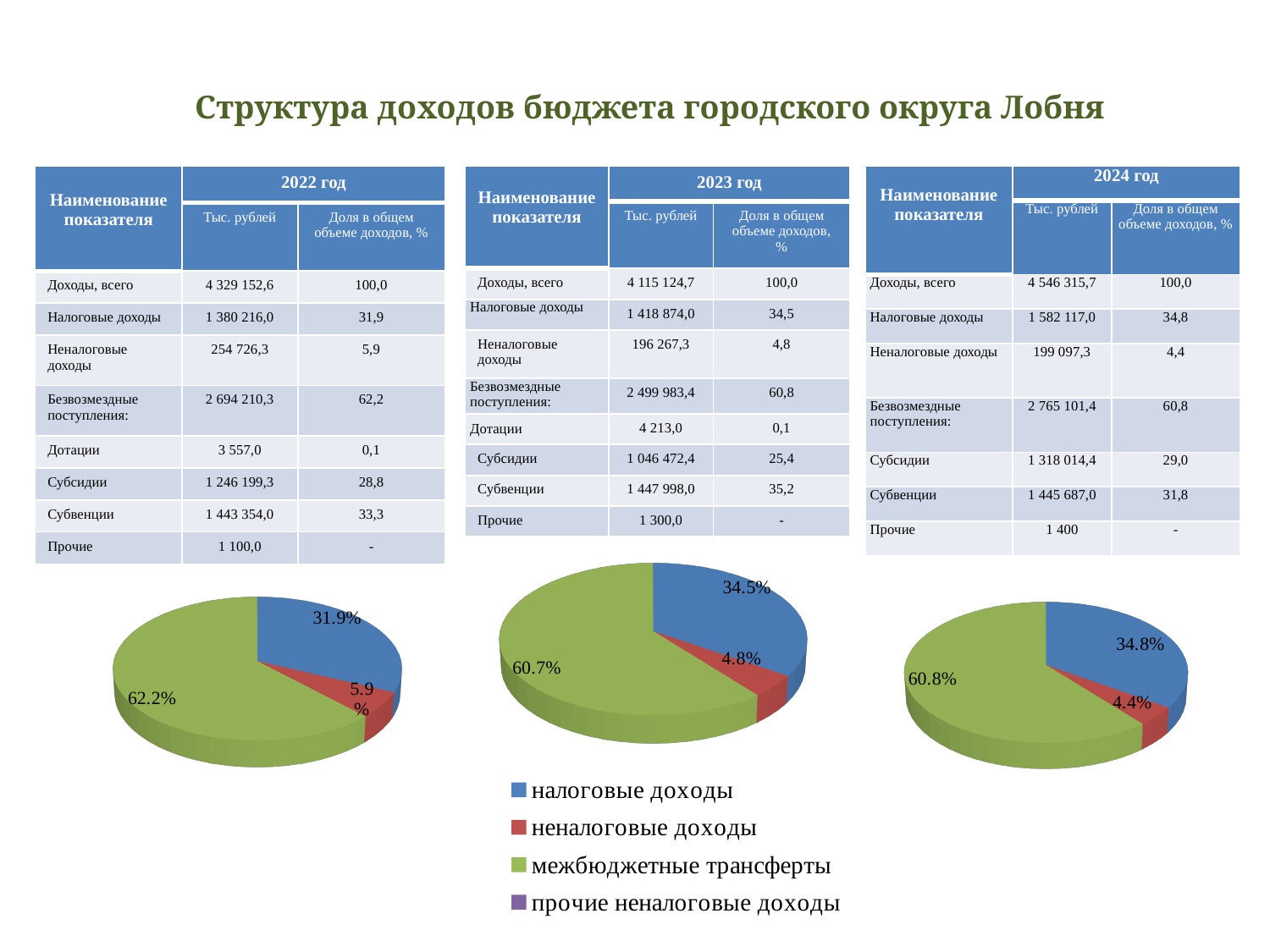
How many pie charts are shown on the slide? 3 In the left pie chart, what share is shown for the blue slice (налоговые доходы)? 31.9% What type of chart is used on the slide? pie chart In the middle pie chart, what share is shown for the red slice (неналоговые доходы)? 4.8% Which is larger: the share of налоговые доходы in the left pie chart or in the right pie chart? right pie chart In the right pie chart, what share is shown for the blue slice (налоговые доходы)? 34.8% How many entries does the legend list for the pie charts? 4 In the right pie chart, which category has the largest share? межбюджетные трансферты In the middle pie chart, what share is shown for the green slice (межбюджетные трансферты)? 60.7% In the middle pie chart, what is the difference between the shares of межбюджетные трансферты and налоговые доходы? 26.2% In the left pie chart, what share is shown for the green slice (межбюджетные трансферты)? 62.2%